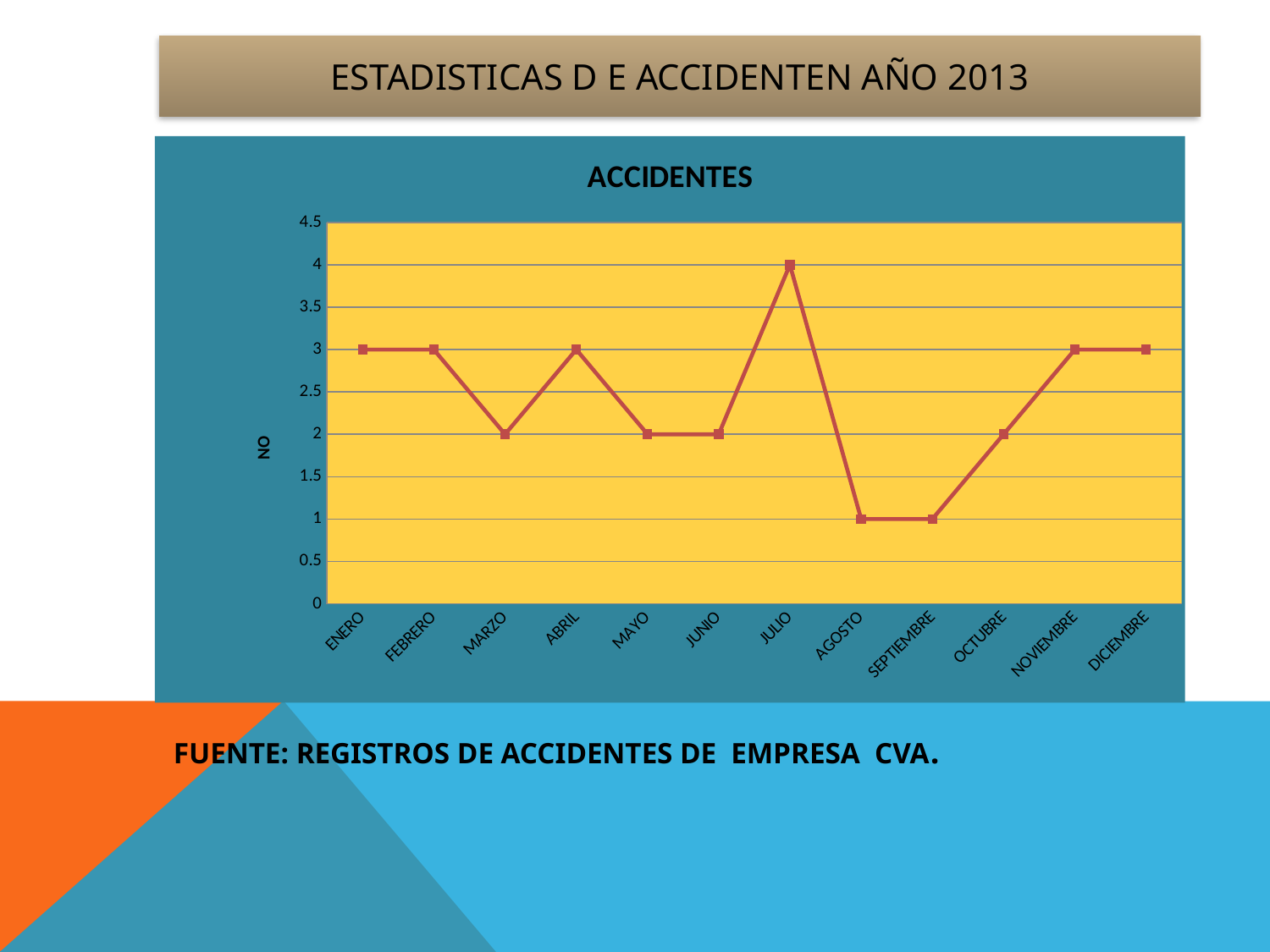
What is the value for AGOSTO? 1 Do the values rise or fall from SEPTIEMBRE to NOVIEMBRE? rise Is the value for JULIO greater or less than 3.5? greater What is the difference between the values for JULIO and SEPTIEMBRE? 3 What is the value for ENERO? 3 What is the value for OCTUBRE? 2 Which month has the highest value? JULIO What is the value for JULIO? 4 What is the title of the chart? ACCIDENTES What type of chart is shown on the slide? Line chart Which is larger, the value for ABRIL or the value for MAYO? ABRIL How many months are plotted on the x axis? 12